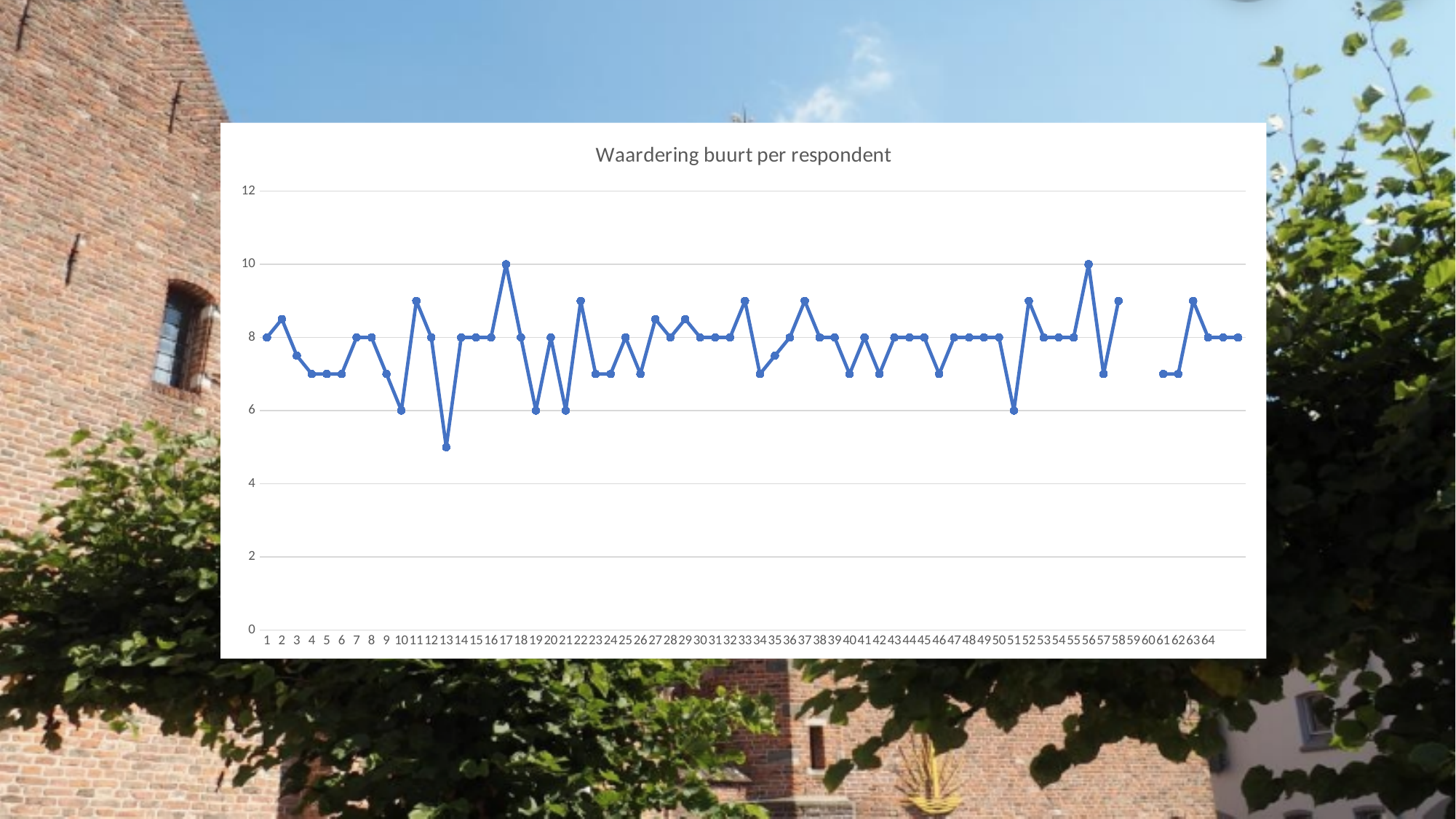
What is the value for respondent 17? 10 What is the value for respondent 1? 8 Which is larger, the value for respondent 17 or the value for respondent 13? respondent 17 What is the difference between the value for respondent 17 and the value for respondent 10? 4 What is the title of the chart? Waardering buurt per respondent Is the value for respondent 2 greater or less than 8? greater Which respondent has the lowest value? 13 What is the value for respondent 10? 6 Is the value for respondent 3 greater or less than 8? less What kind of chart is shown on the slide? line chart How many respondents are labelled along the x axis? 64 Is the value for respondent 13 greater or less than 6? less